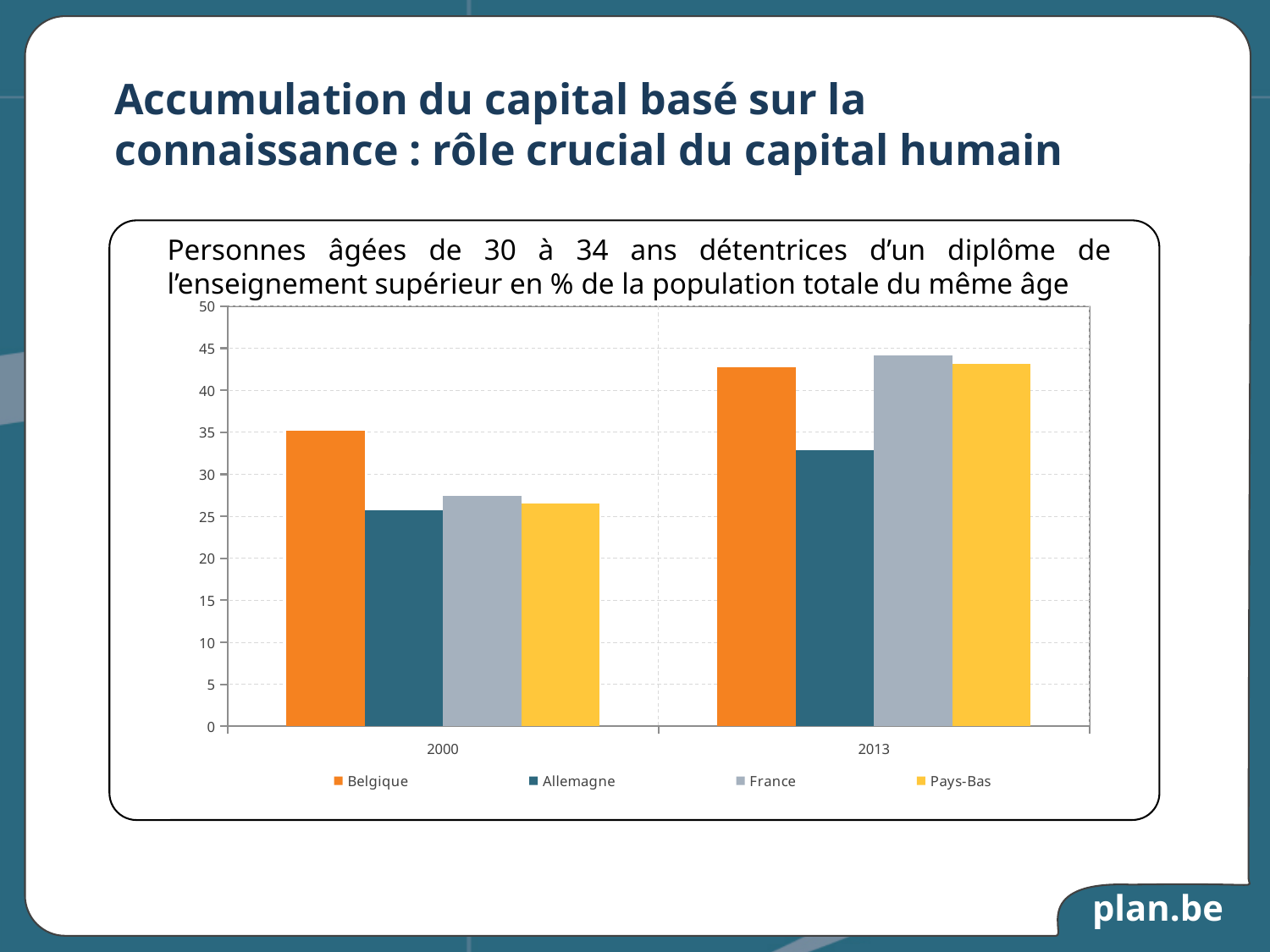
Is the value for France in 2013 greater or less than 40? greater Which colour represents Allemagne in the legend? dark teal blue Which country has the lowest value in 2013? Allemagne Does the value for Pays-Bas rise or fall from 2000 to 2013? rise How many series does the legend list? 4 In 2013, which is larger: the value for Belgique or the value for Allemagne? Belgique What kind of chart is shown on the slide? bar chart Is the value for Belgique in 2000 greater or less than 30? greater How many year categories are shown on the x axis? 2 Is the value for Allemagne in 2000 greater or less than 30? less Which country has the highest value in 2000? Belgique